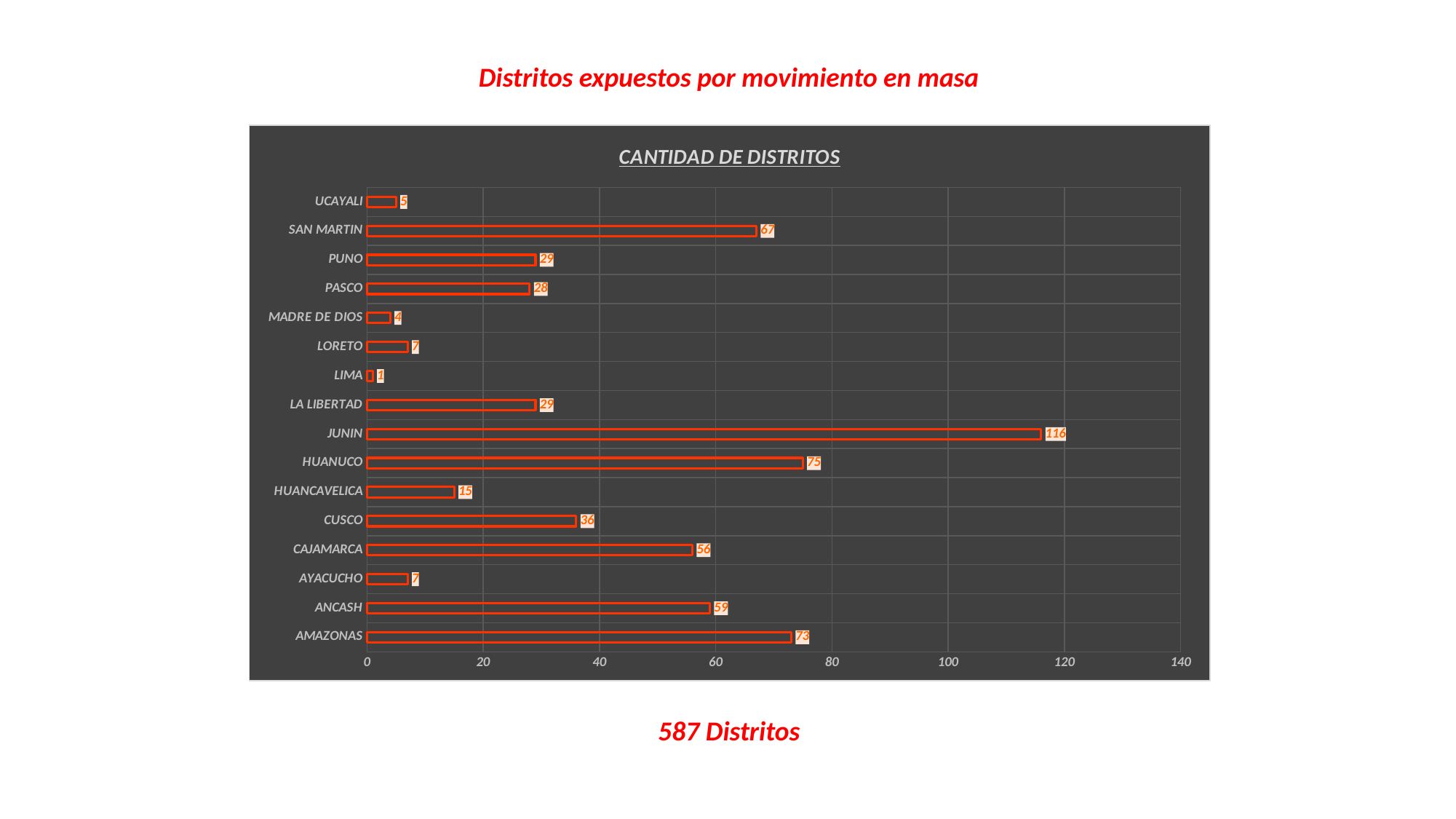
Which is larger, the value for CUSCO or the value for PUNO? CUSCO What kind of chart is shown on the slide? bar chart What is the value for HUANCAVELICA? 15 Which category has the highest value? JUNIN What is the value for CAJAMARCA? 56 What is the title of the chart? CANTIDAD DE DISTRITOS Is the value for SAN MARTIN greater or less than 60? greater How many categories are shown in the chart? 16 What is the difference between the values for HUANUCO and AMAZONAS? 2 What is the difference between the values for SAN MARTIN and ANCASH? 8 What is the value for JUNIN? 116 Which category has the lowest value? LIMA